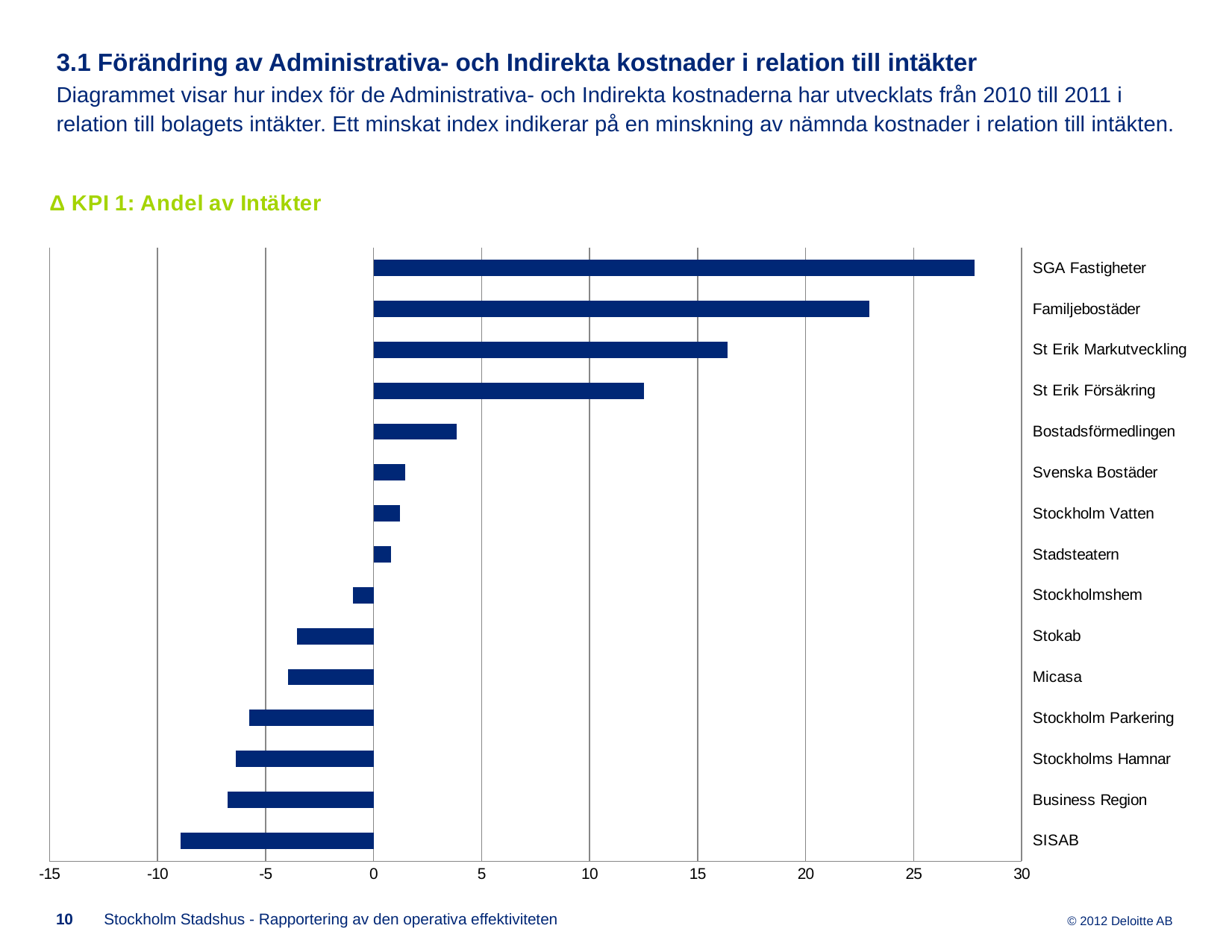
What is the title of the chart? Δ KPI 1: Andel av Intäkter Is the value for Bostadsförmedlingen greater or less than 5? less Is the value for Familjebostäder greater or less than 20? greater Which has the larger value, Stockholmshem or Stockholm Parkering? Stockholmshem Is the value for SISAB greater or less than -5? less How many companies are listed as categories in the chart? 15 Which company has the highest value in the chart? SGA Fastigheter What kind of chart is shown on the slide? bar chart Which has the larger value, St Erik Markutveckling or St Erik Försäkring? St Erik Markutveckling Which company has the lowest value in the chart? SISAB